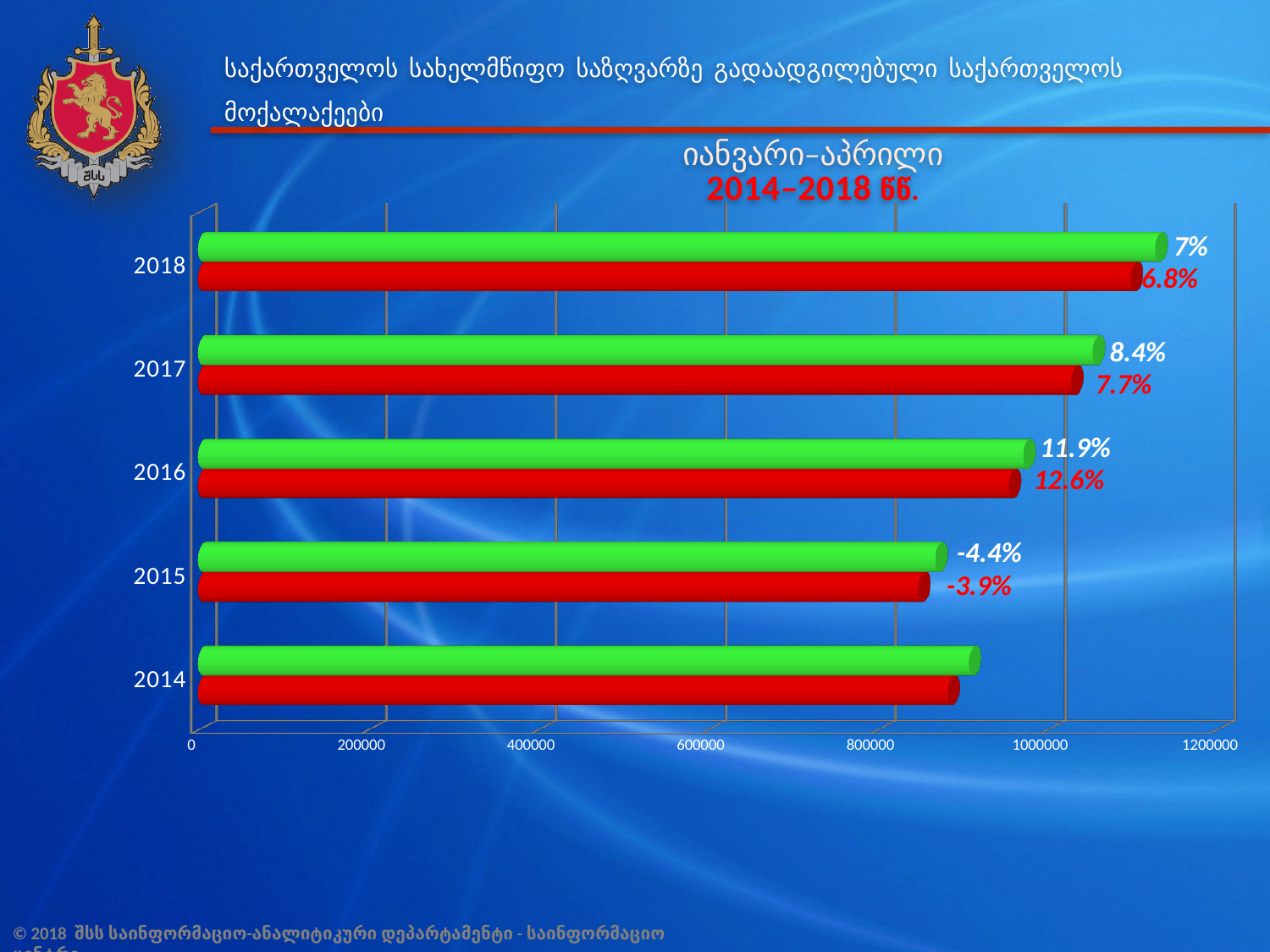
Is the red bar for 2014 greater or less than 1000000? less Is the green bar for 2018 greater or less than 1000000? greater What percentage label is shown on the red bar for 2015? -3.9% What percentage label is shown on the green bar for 2016? 11.9% Which year has the longest green bar? 2018 What percentage label is shown on the red bar for 2018? 6.8% Which year has the shortest red bar? 2015 What is the highest value shown on the horizontal axis of the chart? 1200000 What percentage label is shown on the red bar for 2017? 7.7% What percentage label is shown on the green bar for 2018? 7% What kind of chart is shown on the slide? bar chart How many years are shown on the vertical axis of the chart? 5